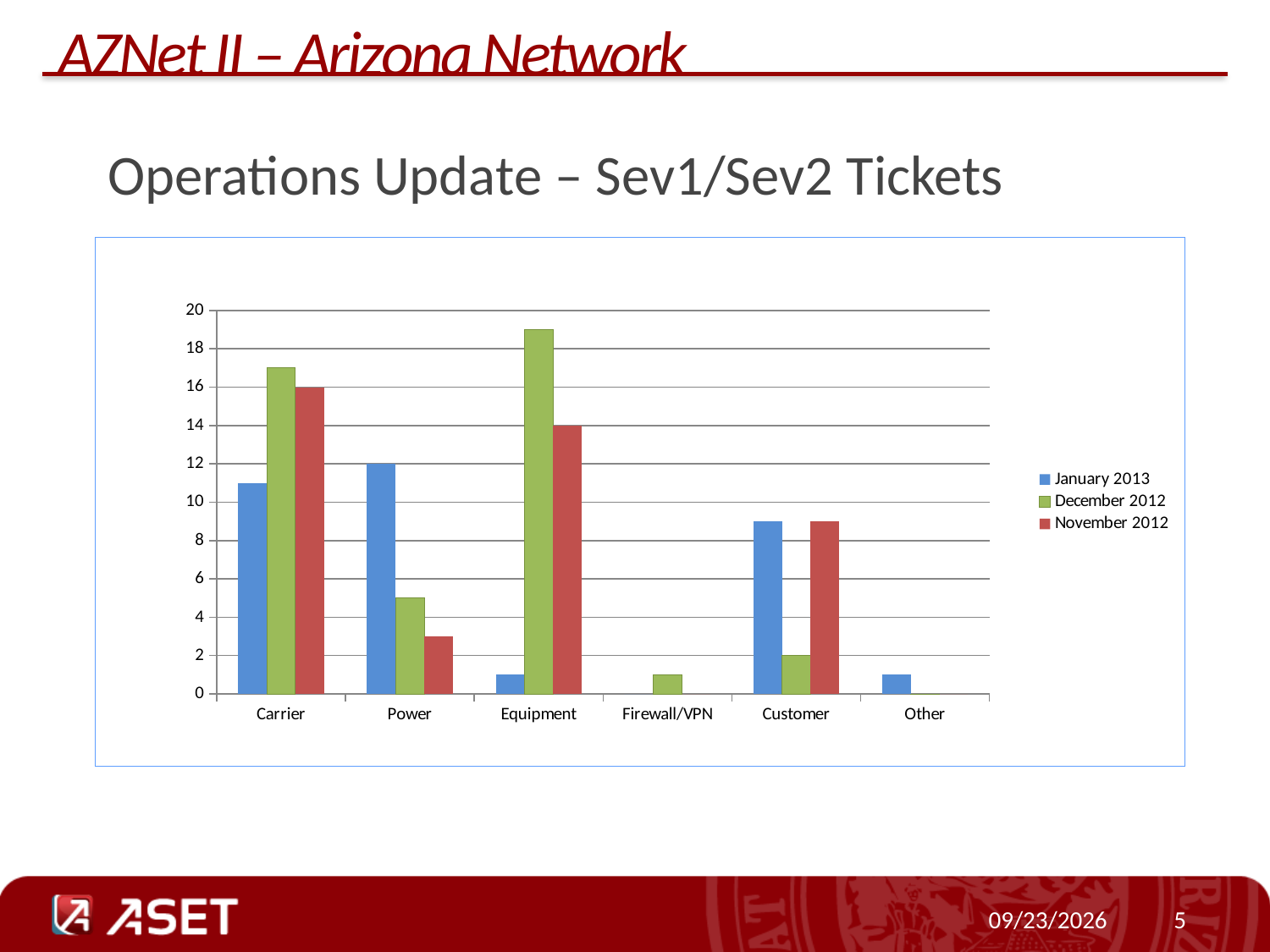
What is the value for November 2012 in the Carrier category? 16 How many categories are shown on the x axis? 6 What is the value for December 2012 in the Customer category? 2 Which is larger in the Power category: the January 2013 value or the December 2012 value? January 2013 What kind of chart is shown on the slide? bar chart What is the value for January 2013 in the Power category? 12 What is the value for November 2012 in the Equipment category? 14 Which series is shown in green in the legend? December 2012 How many series does the legend list? 3 Is the value for December 2012 in the Carrier category greater or less than 16? greater Which category has the highest December 2012 value? Equipment